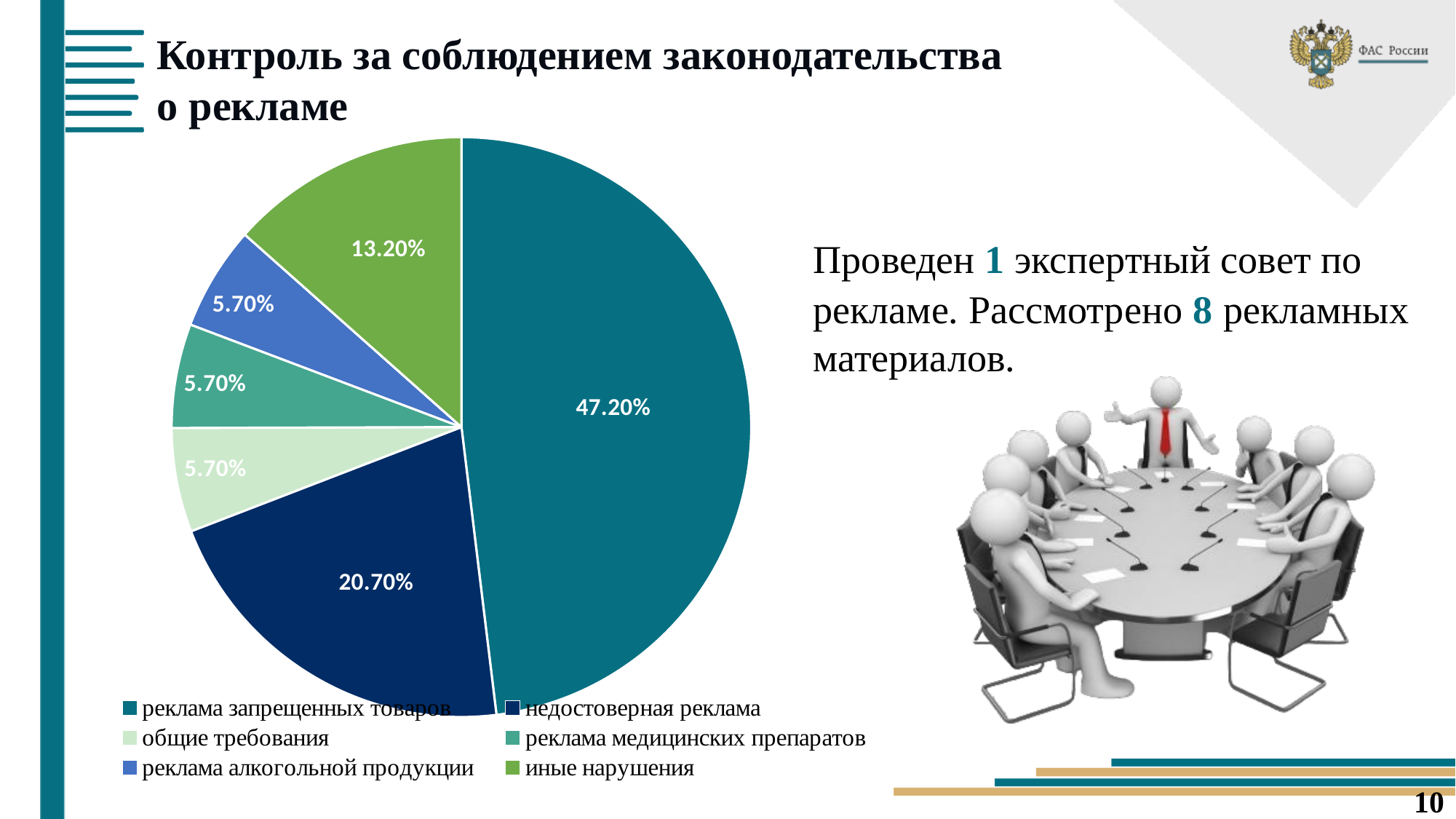
Which category has the largest slice of the pie? реклама запрещенных товаров How many slices does the pie chart have? 6 What is the difference between the shares of "реклама запрещенных товаров" and "недостоверная реклама"? 26.50% What share of the pie does "иные нарушения" have? 13.20% What kind of chart is shown on the slide? pie chart Which is larger: the share of "иные нарушения" or the share of "реклама медицинских препаратов"? иные нарушения How many entries does the legend list? 6 What share of the pie does "реклама запрещенных товаров" have? 47.20% What share of the pie does "недостоверная реклама" have? 20.70% What share of the pie does "реклама алкогольной продукции" have? 5.70% What share of the pie does "общие требования" have? 5.70%